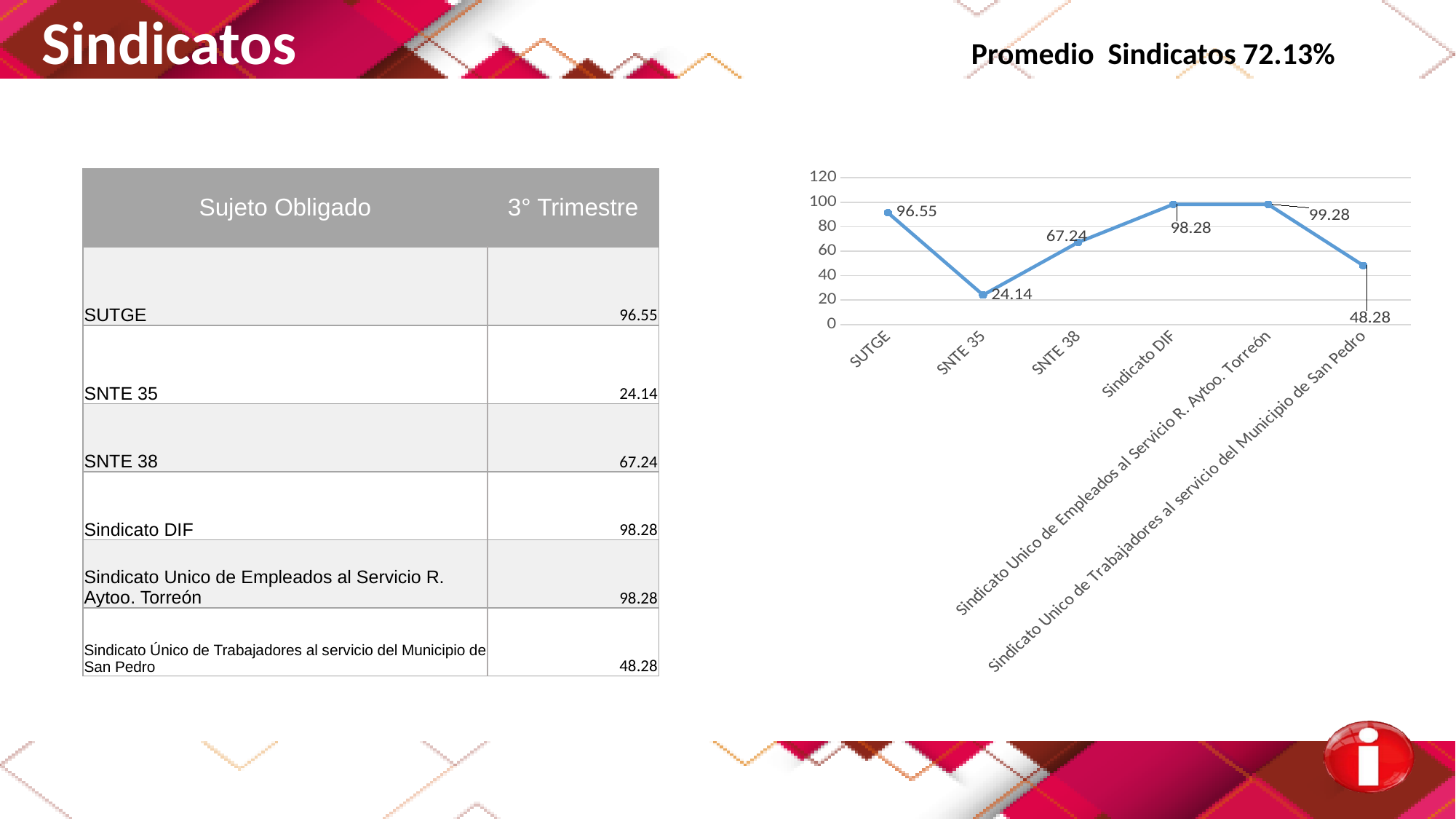
What is the value plotted for Sindicato DIF? 98.28 Which is larger, the value for SNTE 38 or the value for Sindicato Unico de Trabajadores al servicio del Municipio de San Pedro? SNTE 38 Which category has the lowest value in the chart? SNTE 35 What is the value plotted for Sindicato Unico de Trabajadores al servicio del Municipio de San Pedro? 48.28 Does the line rise or fall between SNTE 35 and SNTE 38? rise What is the value plotted for SNTE 38? 67.24 What is the value plotted for SNTE 35? 24.14 Is the value for SNTE 35 greater or less than 40? less What kind of chart is shown on the slide? line chart How many categories are plotted on the x axis of the chart? 6 What is the value plotted for SUTGE? 96.55 What is the difference between the values for SUTGE and SNTE 35? 72.41